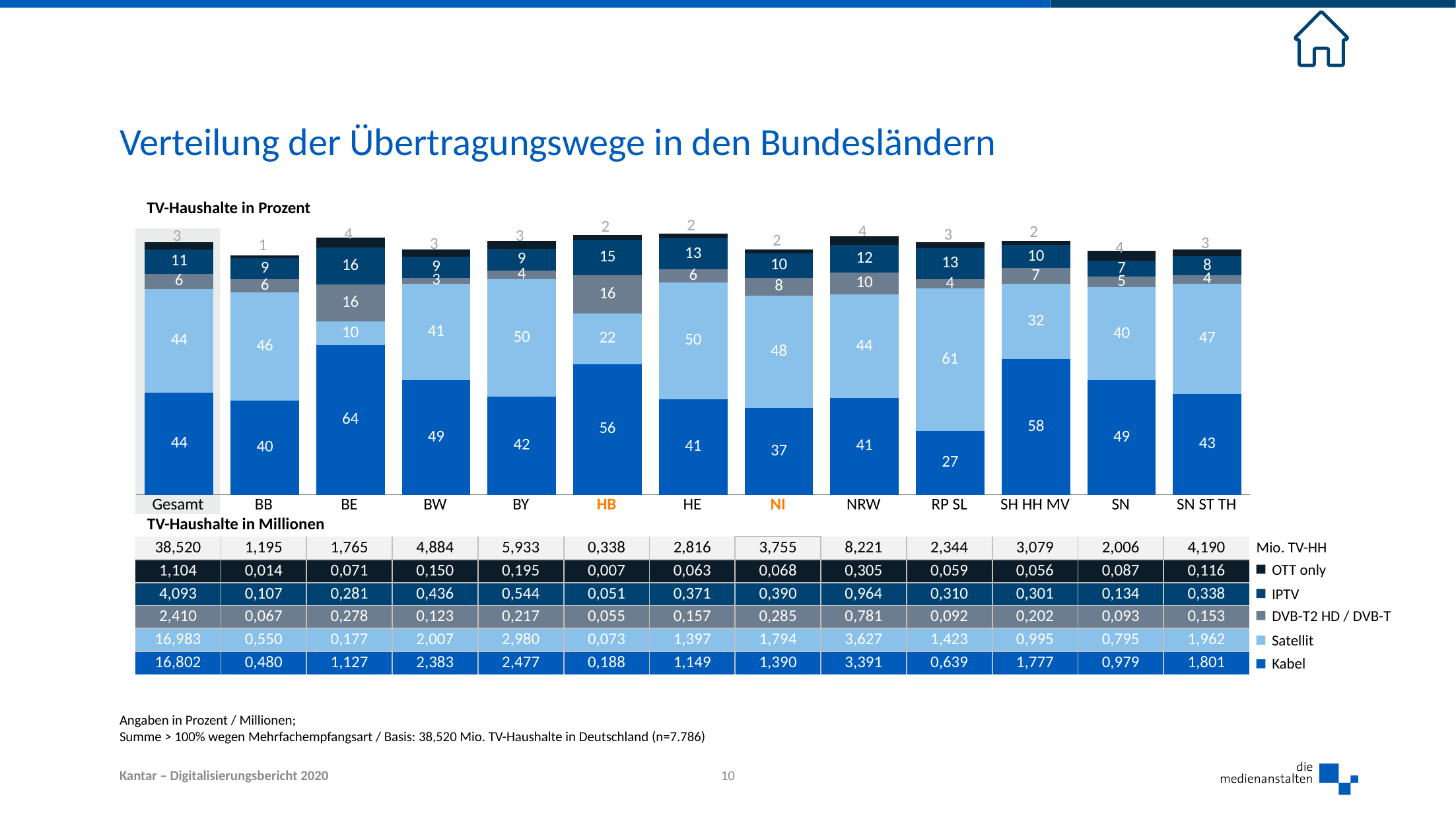
What kind of chart is shown on the slide? stacked bar chart What is the difference between the Kabel percentage for BE and for RP SL? 37 In the table, how many Mio. TV-HH are listed for NRW? 8,221 How many categories (bars) are shown along the x axis? 13 Is the Satellit percentage larger for BY or for HB? BY What is the Satellit percentage for RP SL? 61 What is the Kabel percentage for BE? 64 How many series does the legend list? 5 Which category has the lowest Kabel percentage? RP SL Which category has the highest Kabel percentage? BE Which category has the lowest Satellit percentage? BE What is the IPTV percentage for HB? 15